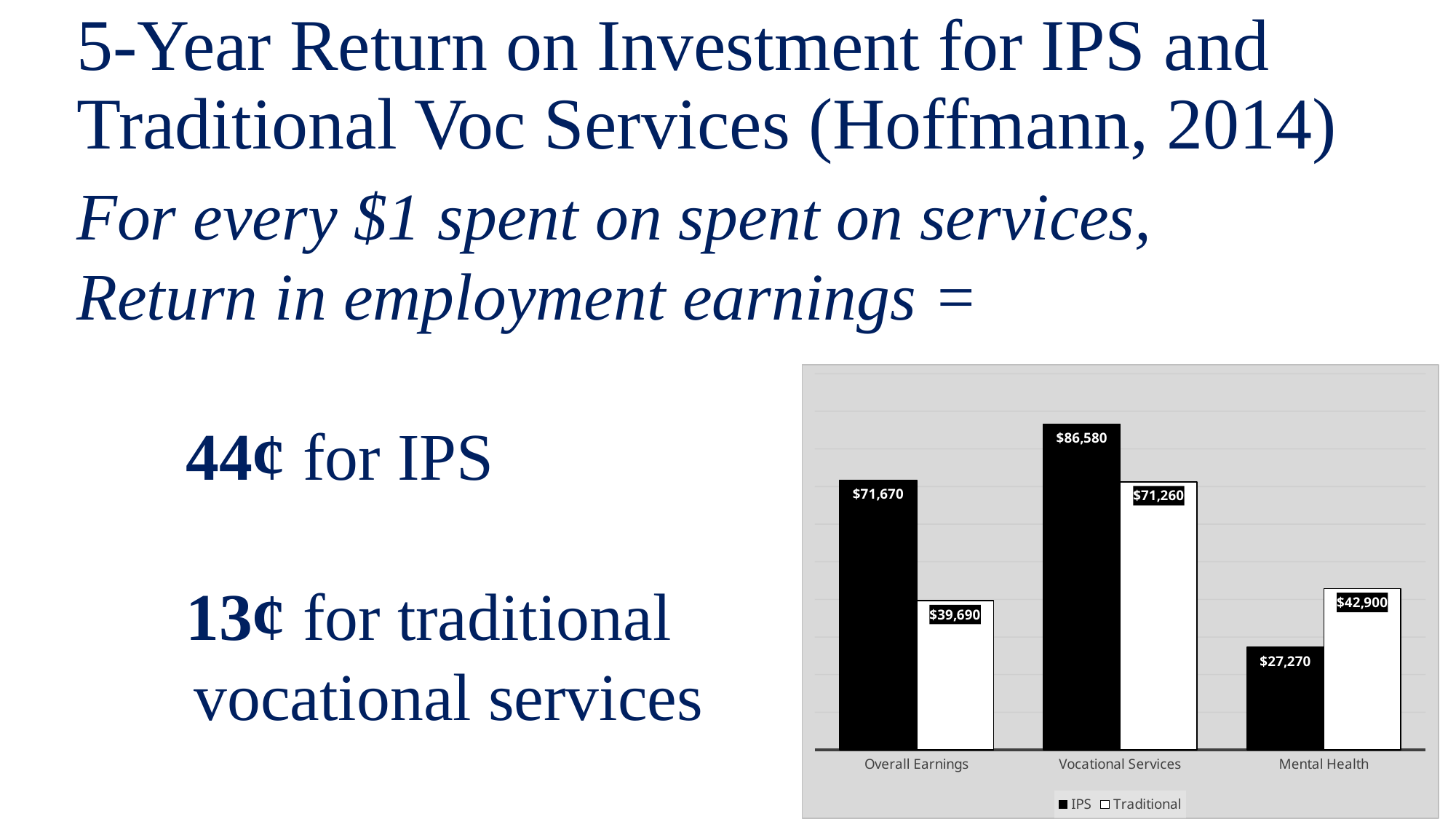
What is the difference between the IPS and Traditional values for Overall Earnings? $31,980 What kind of chart is shown on the slide? Bar chart Which series is shown with black bars? IPS How many series does the chart legend list? 2 What is the IPS value for Overall Earnings? $71,670 What is the Traditional value for Mental Health? $42,900 Which is larger for Mental Health, the IPS value or the Traditional value? Traditional What is the Traditional value for Vocational Services? $71,260 How many categories are shown on the x axis of the chart? 3 Which category has the lowest Traditional value? Overall Earnings Which category has the highest IPS value? Vocational Services What is the IPS value for Mental Health? $27,270